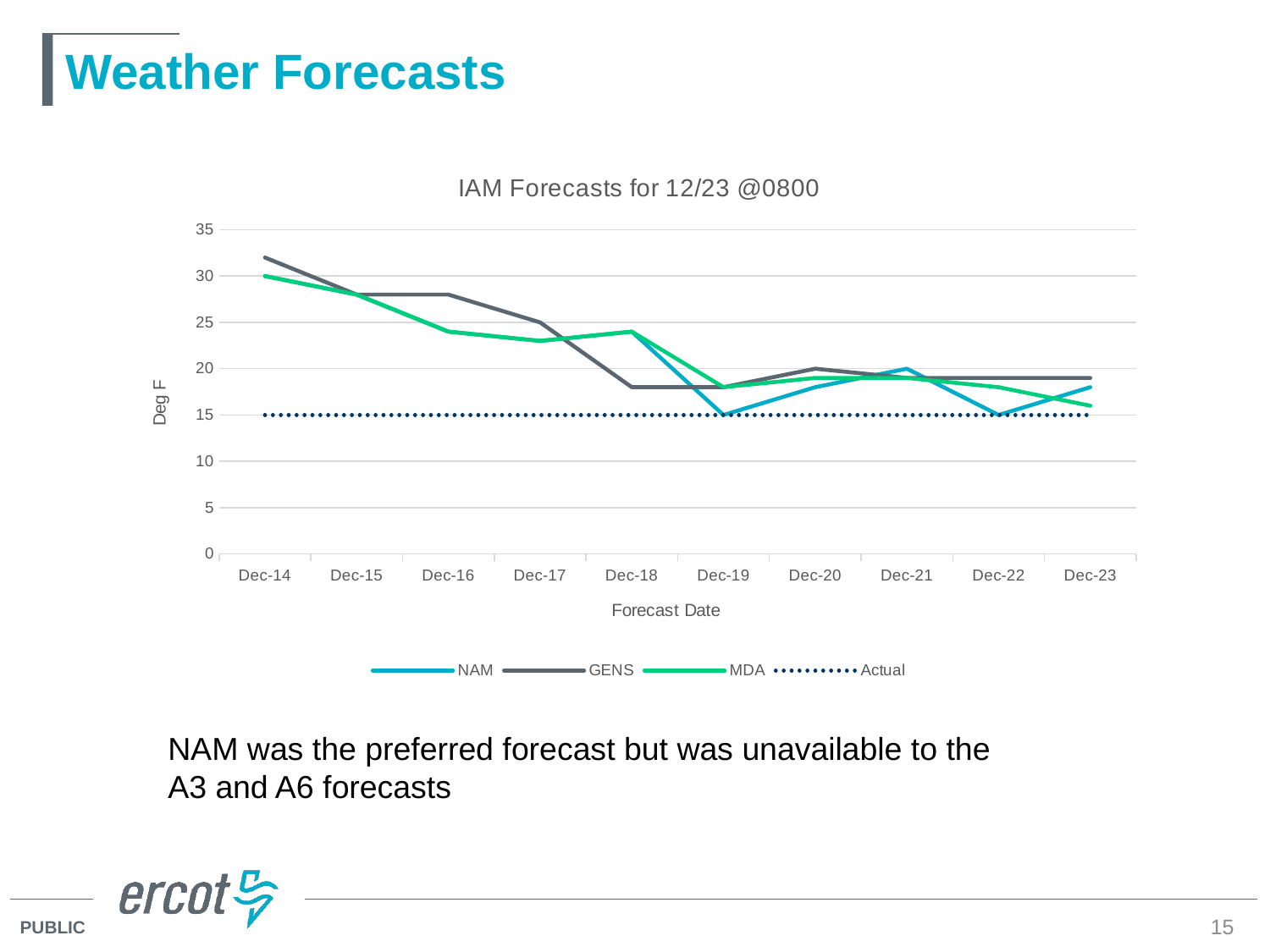
Is the NAM value for Dec-16 greater or less than 25? less What is the title of the chart? IAM Forecasts for 12/23 @0800 How many forecast dates are shown on the x axis? 10 What is the value of the Actual series across the forecast dates? 15 What kind of chart is shown on the slide? line chart Is the GENS value for Dec-14 greater or less than 30? greater Does the GENS series rise or fall from Dec-14 to Dec-18? fall Is the GENS value for Dec-18 greater or less than 20? less Which series has the highest value at Dec-14? GENS At Dec-18, which is higher, the GENS value or the MDA value? MDA How many series does the legend list? 4 What is the label of the y axis? Deg F